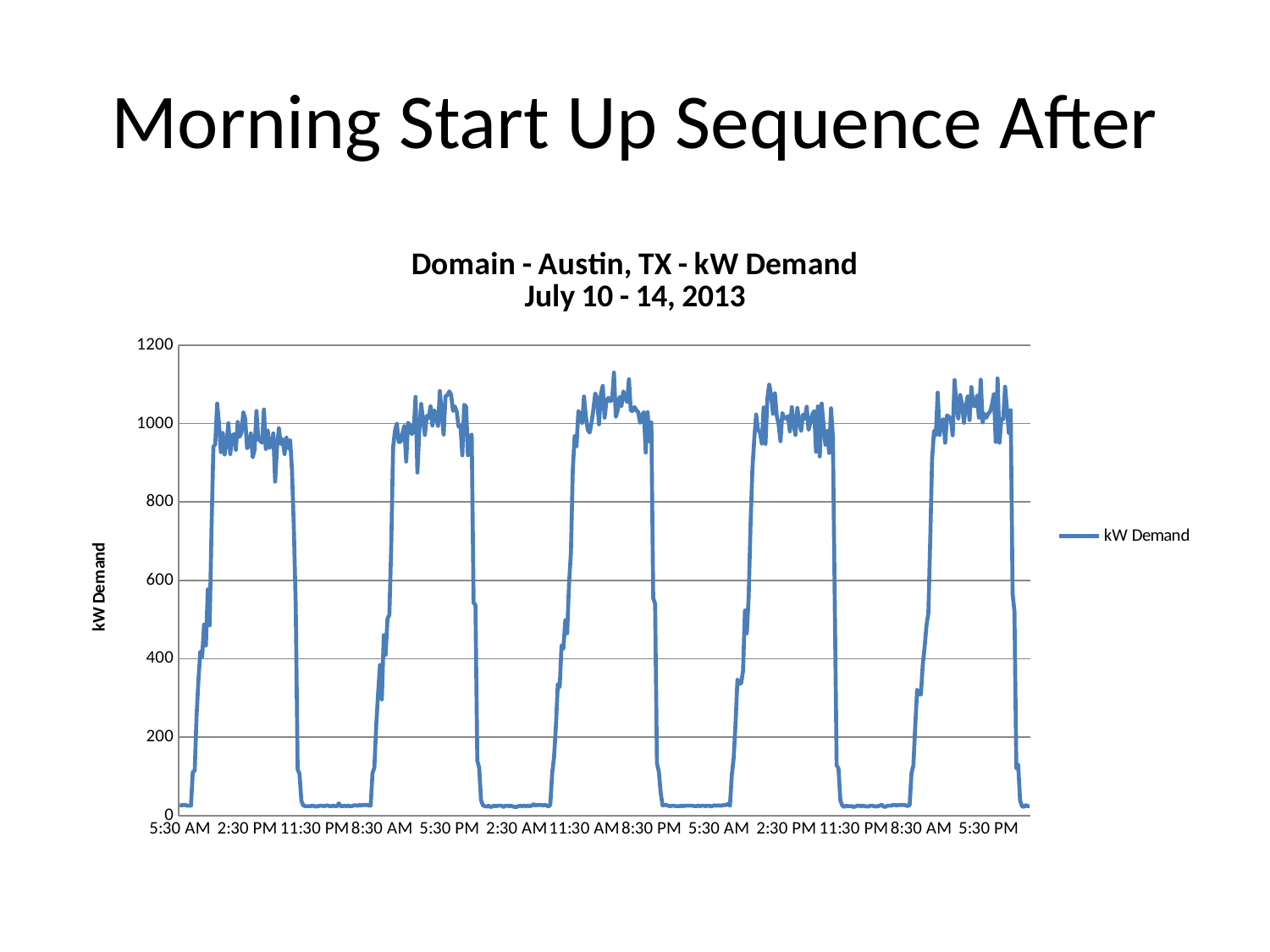
What is the title of the chart? Domain - Austin, TX - kW Demand July 10 - 14, 2013 Is the value of kW Demand at the first 11:30 PM tick greater or less than 200? less Is the value of kW Demand at the first 5:30 AM tick greater or less than 200? less Is the value of kW Demand at the first 2:30 PM tick greater or less than 800? greater How many daily peaks (high plateaus) does the kW Demand line show? 5 How many time labels are shown along the horizontal axis? 13 How many series does the legend list? 1 What is the name of the series shown in the legend? kW Demand What is the highest value shown on the vertical axis? 1200 What kind of chart is shown on the slide? line chart